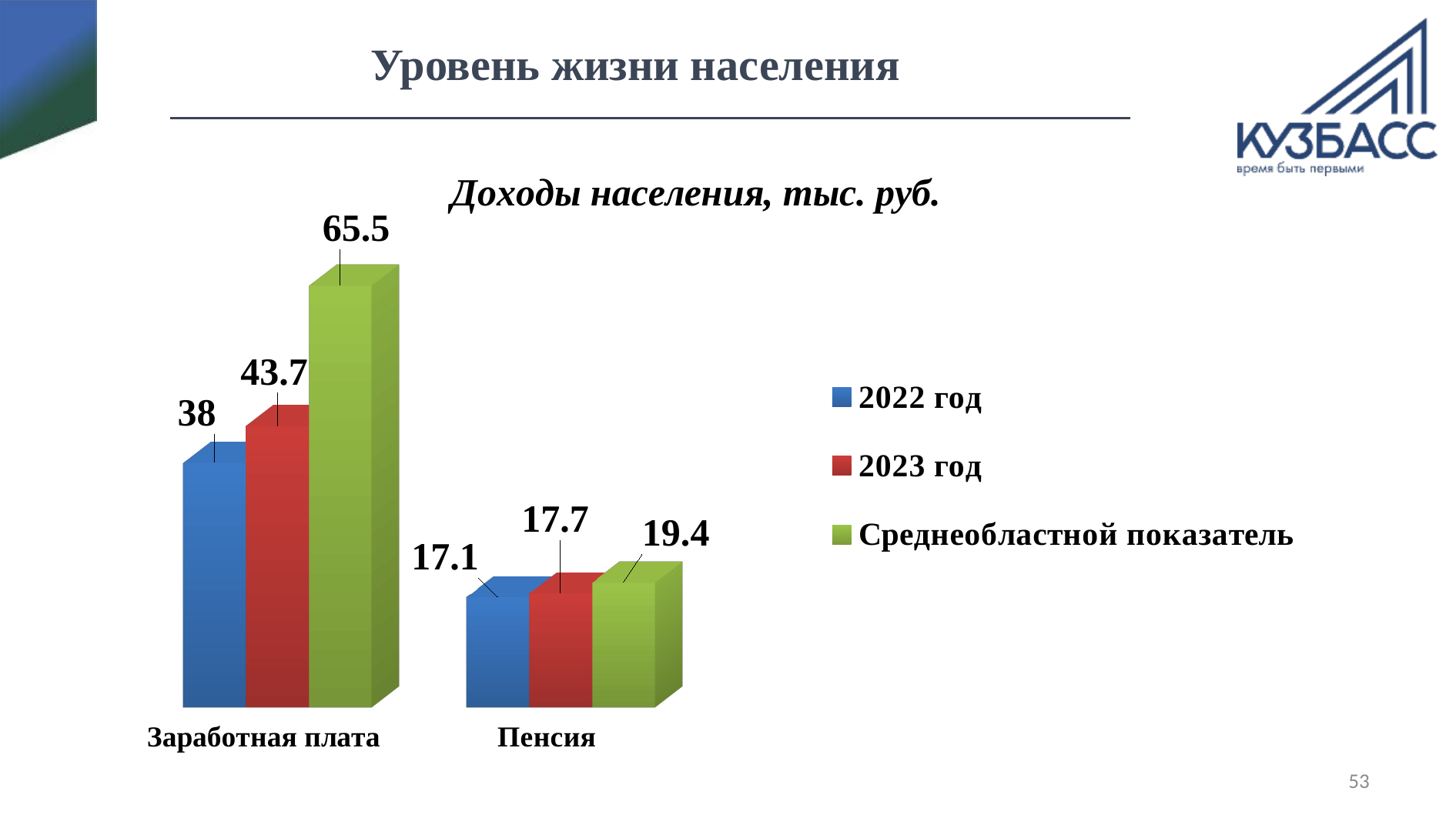
What is the difference between the 2023 год and 2022 год values for Пенсия? 0.6 How many series does the legend list? 3 What is the Среднеобластной показатель value for Пенсия? 19.4 What is the title of the chart? Доходы населения, тыс. руб. Which series has the highest value for Заработная плата? Среднеобластной показатель Which series has the lowest value for Пенсия? 2022 год What is the difference between the Среднеобластной показатель and the 2023 год value for Заработная плата? 21.8 What is the value for Пенсия in 2023 год? 17.7 What is the value for Пенсия in 2022 год? 17.1 What is the value for Заработная плата in 2023 год? 43.7 What is the Среднеобластной показатель value for Заработная плата? 65.5 What is the value for Заработная плата in 2022 год? 38